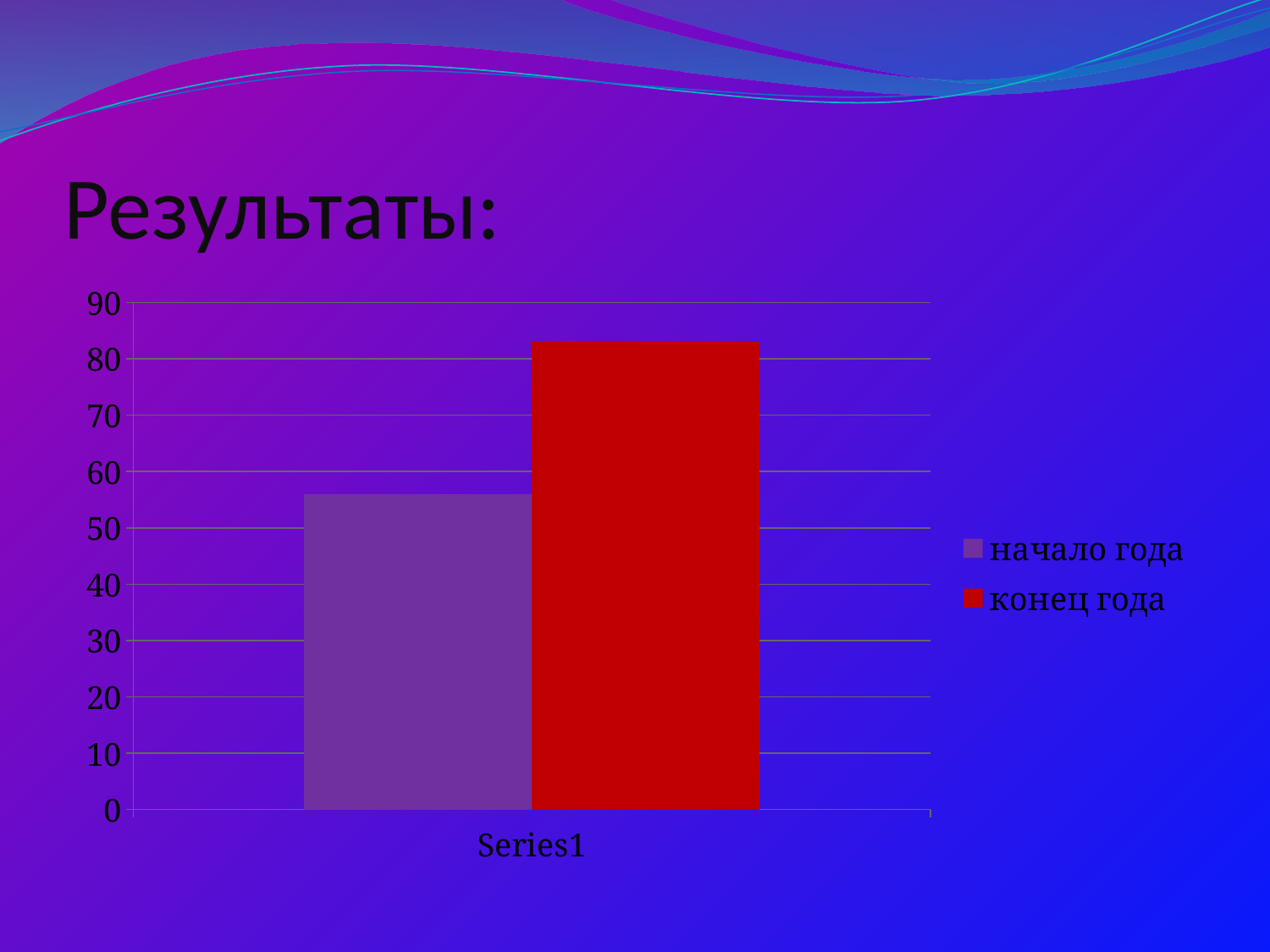
Which series has the lowest value? начало года Which series has the taller bar, начало года or конец года? конец года Is the value for начало года greater or less than 60? less What is the title of the slide above the chart? Результаты: Is the value for начало года greater or less than 50? greater Is the value for конец года greater or less than 80? greater What colour is the bar for конец года? red How many series does the legend list? 2 How many categories are shown on the x axis? 1 Which series has the highest value? конец года What kind of chart is shown on the slide? bar chart